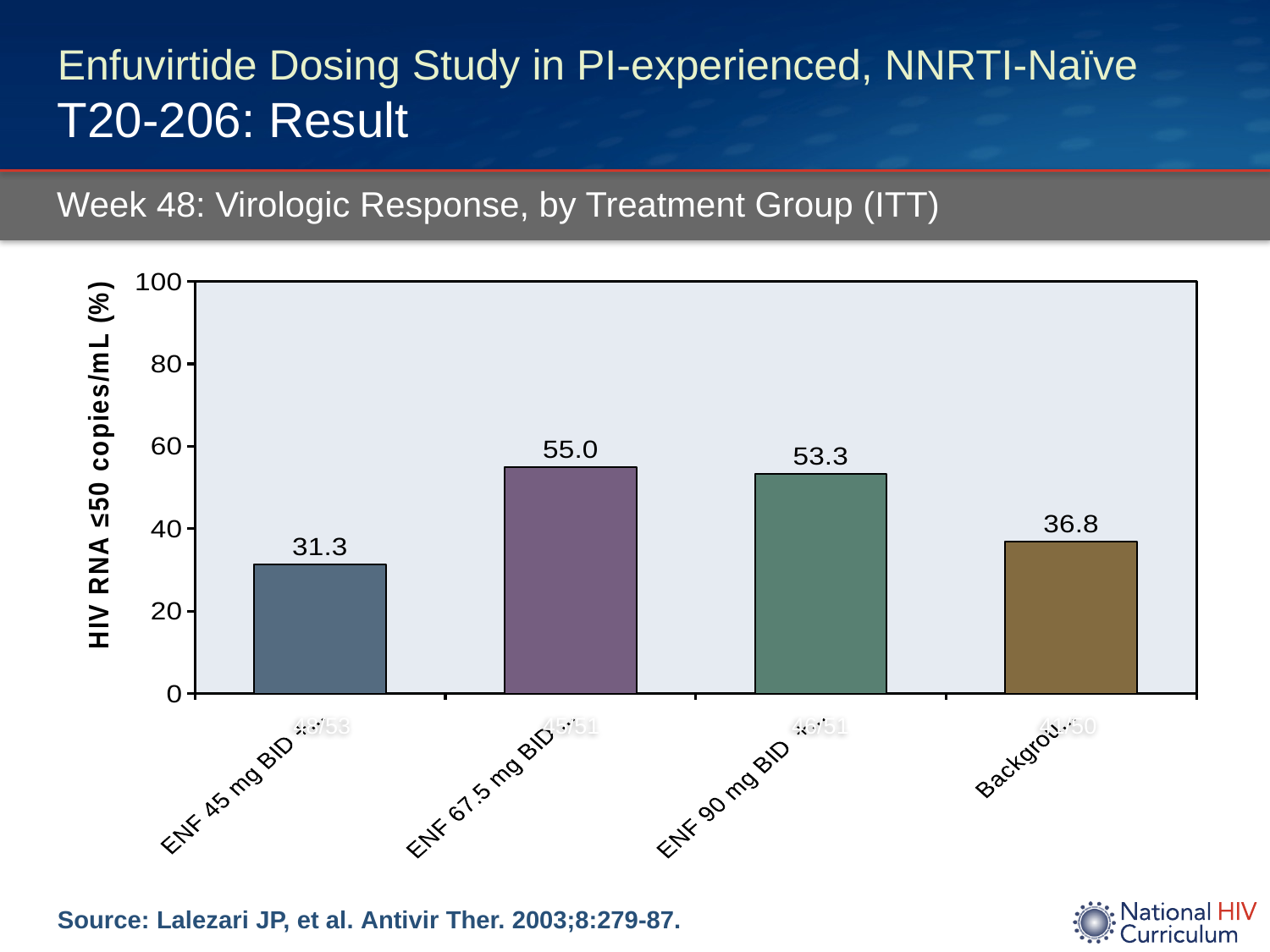
What is the value for ENF 45 mg BID? 31.3 What is the value for ENF 90 mg BID? 53.3 What is the value for ENF 67.5 mg BID? 55.0 Which treatment group has the highest value? ENF 67.5 mg BID How many treatment groups are plotted in the chart? 4 What is the value for the Background group? 36.8 What is the difference between the values for ENF 90 mg BID and Background? 16.5 Which is larger, the value for ENF 90 mg BID or the value for Background? ENF 90 mg BID What is the label of the y axis? HIV RNA ≤50 copies/mL (%) What is the difference between the values for ENF 67.5 mg BID and ENF 45 mg BID? 23.7 Which treatment group has the lowest value? ENF 45 mg BID What kind of chart is shown on the slide? bar chart